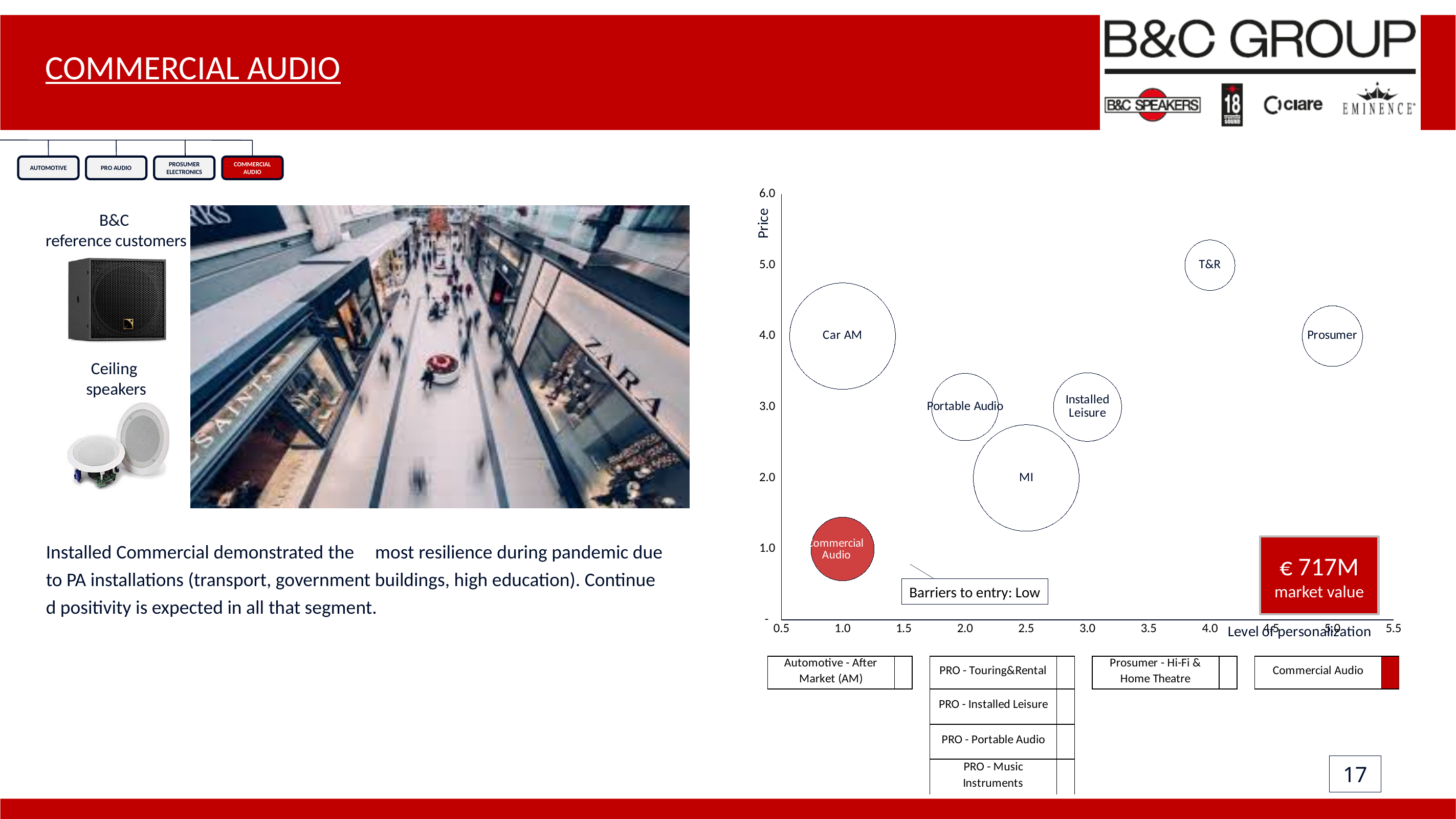
What is the label on the y axis of the chart? Price Which bubble has the highest Level of personalization on the chart? Prosumer Is the Price value for the Car AM bubble greater or less than 3.0? greater Which bubble has a higher Price, Installed Leisure or MI? Installed Leisure How many bubbles are plotted on the chart? 7 Is the Price value for the Commercial Audio bubble greater or less than 2.0? less What kind of chart is shown on the right side of the slide? bubble chart What colour is the Commercial Audio bubble on the chart? red Is the Level of personalization for the T&R bubble greater or less than 3.0? greater Which bubble has the highest Price value on the chart? T&R Which bubble has the lowest Price value on the chart? Commercial Audio How many entries does the legend below the chart list? 7